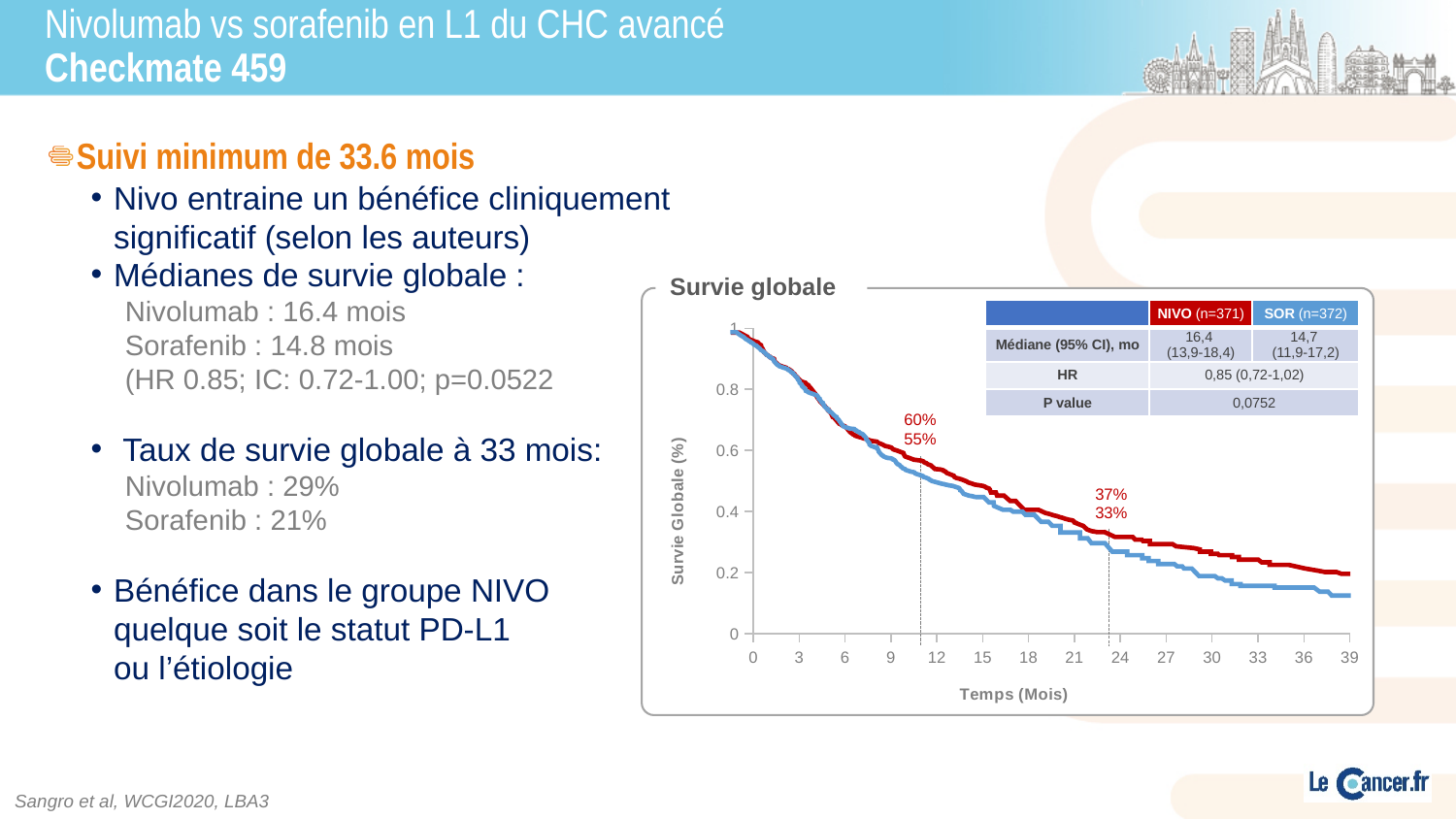
What are the two survival rates labelled at the second dashed vertical line on the chart? 37% and 33% Do the survival curves rise or fall as time (months) increases along the x axis? Fall What is the difference between the two survival rates labelled at the first dashed vertical line (60% and 55%)? 5 percentage points According to the table inside the chart, what is the median overall survival for NIVO (n=371)? 16,4 (13,9-18,4) What is the label of the x axis of the chart? Temps (Mois) What is the title of the chart on the slide? Survie globale What kind of chart is shown under the title "Survie globale"? Line chart (survival curve) According to the table inside the chart, what is the HR value? 0,85 (0,72-1,02) What is the higher survival rate labelled at the first dashed vertical line on the chart? 60% What is the difference between the two survival rates labelled at the second dashed vertical line (37% and 33%)? 4 percentage points According to the table inside the chart, what is the median overall survival for SOR (n=372)? 14,7 (11,9-17,2) What is the lower survival rate labelled at the first dashed vertical line on the chart? 55%